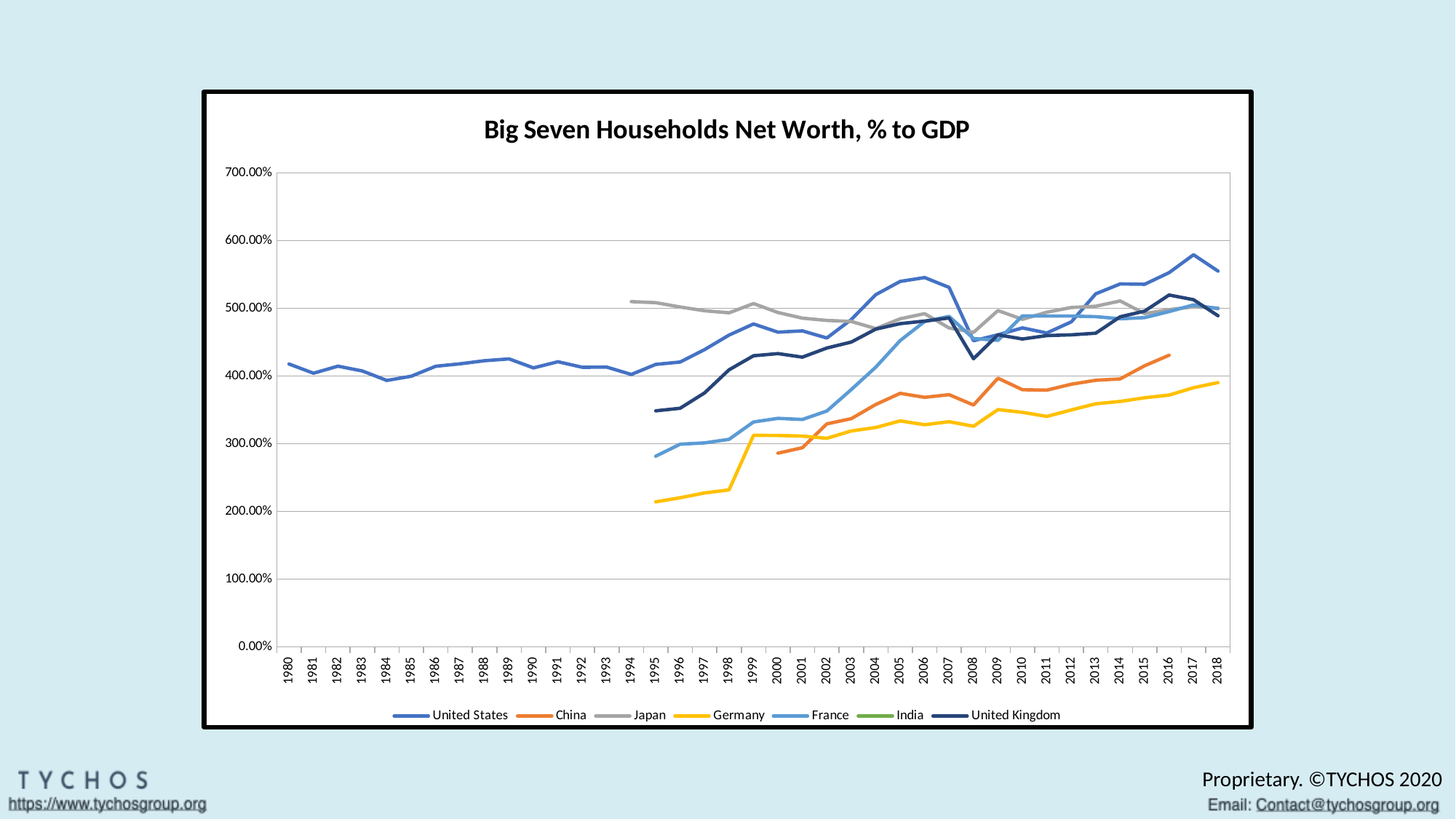
Which series has the highest value in 2017? United States Which series has the lowest value in 1995? Germany How many years are shown on the x axis? 39 Is the value for Germany in 1995 greater or less than 300.00%? less Is the value for United Kingdom in 1995 greater or less than 400.00%? less Is the value for United States in 2017 greater or less than 500.00%? greater Does the Germany line rise or fall overall from 1995 to 2018? Rises In 2005, which is higher: Japan or China? Japan What is the title of the chart? Big Seven Households Net Worth, % to GDP What type of chart is shown on the slide? Line chart How many series does the legend list? 7